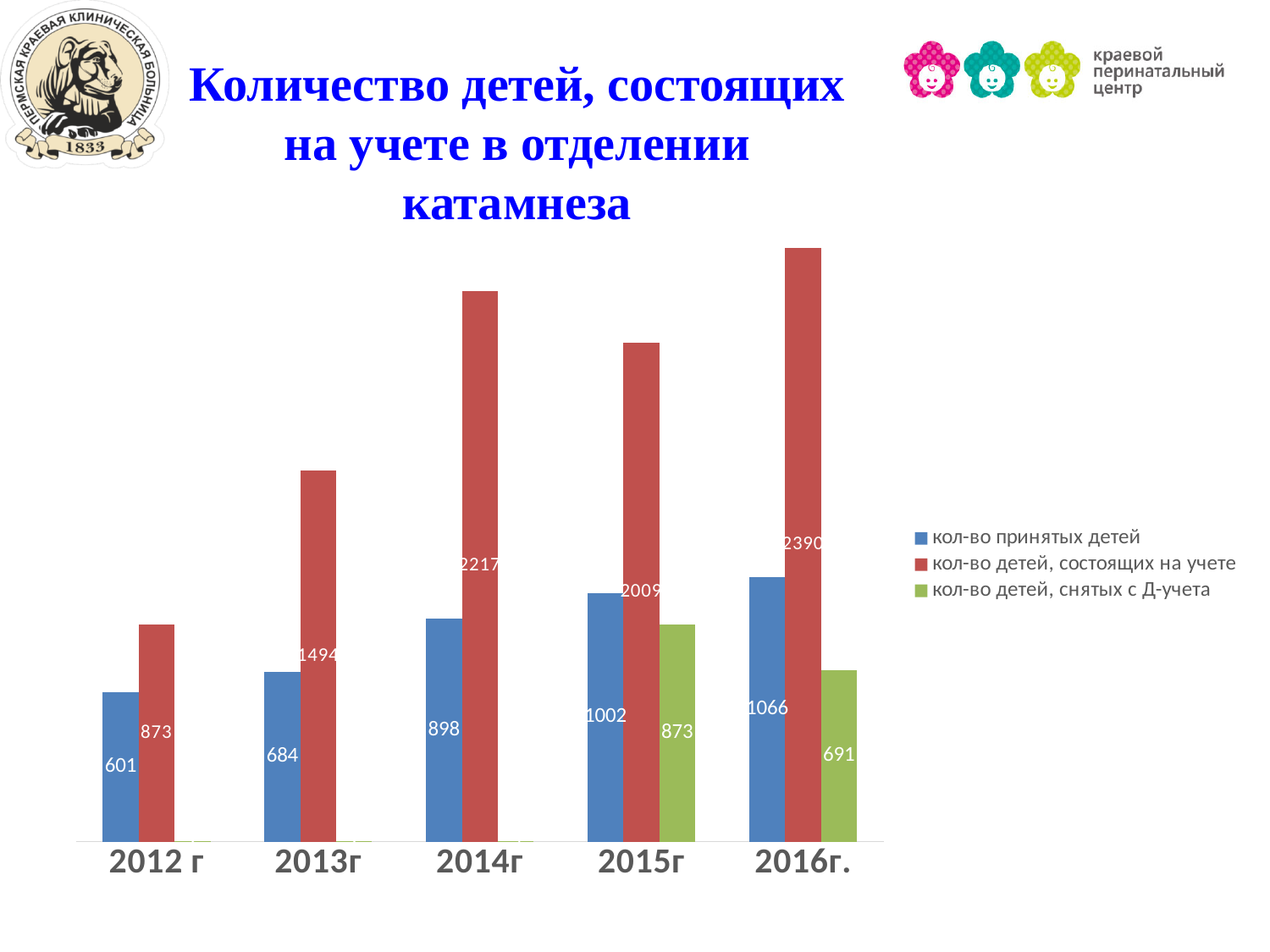
In which year is "кол-во детей, состоящих на учете" highest? 2016г. What is the value for "кол-во принятых детей" in 2015г? 1002 In which year is "кол-во принятых детей" lowest? 2012 г What is the value for "кол-во принятых детей" in 2012 г? 601 What is the difference between "кол-во детей, состоящих на учете" in 2016г. and in 2015г? 381 Which is larger: "кол-во детей, состоящих на учете" in 2014г or in 2015г? 2014г What is the value for "кол-во детей, снятых с Д-учета" in 2016г.? 691 How many years are shown on the x axis? 5 What is the value for "кол-во детей, состоящих на учете" in 2014г? 2217 What kind of chart is shown on the slide? Bar chart Does "кол-во принятых детей" rise or fall from 2012 г to 2016г.? Rises How many series does the legend list? 3